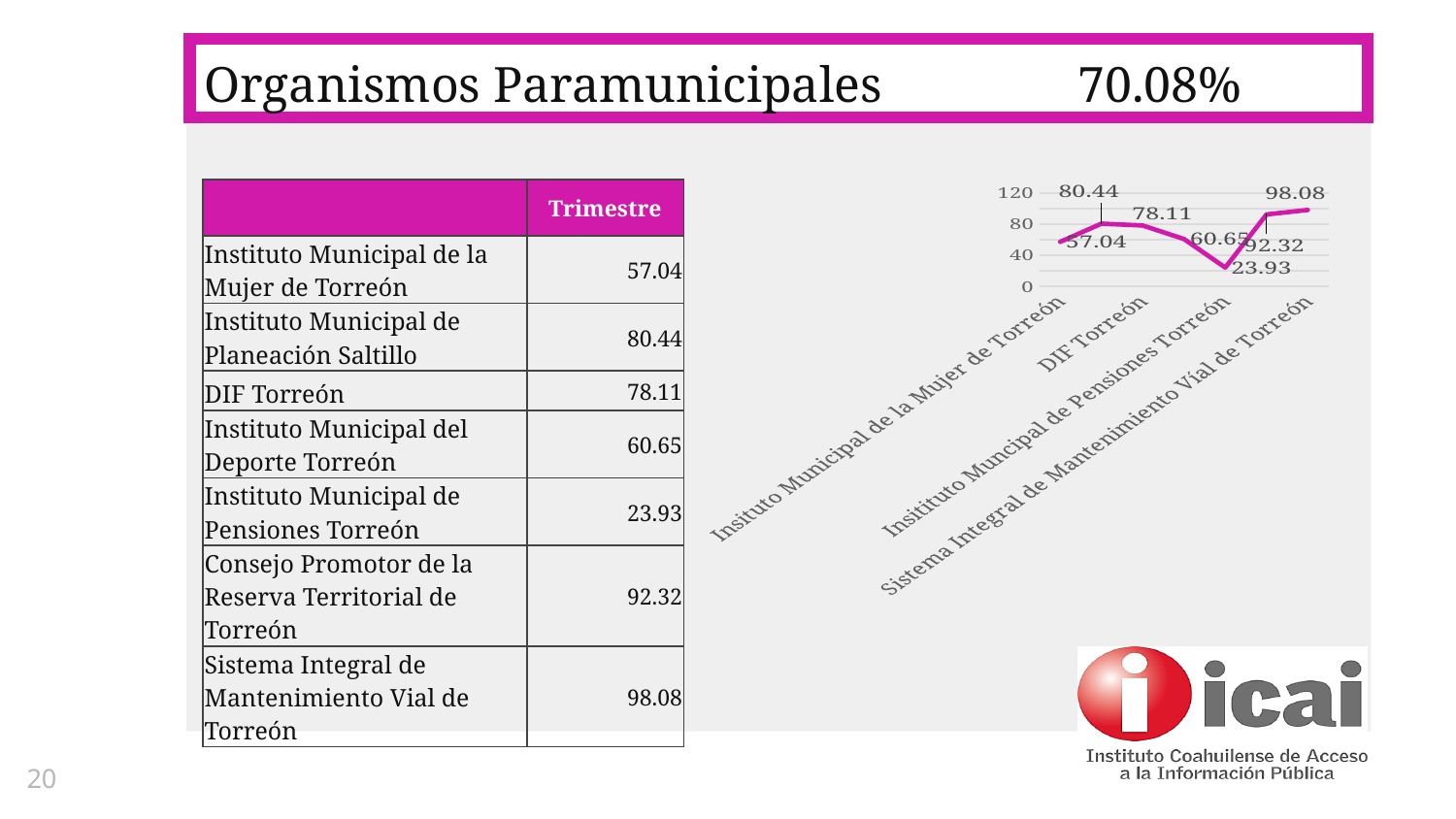
Is the value for Instituto Municipal de Pensiones Torreón on the line chart greater or less than 40? less What is the value plotted for DIF Torreón on the line chart? 78.11 What percentage is shown in the slide title next to "Organismos Paramunicipales"? 70.08% What is the difference between the values for Sistema Integral de Mantenimiento Vial de Torreón (98.08) and Instituto Municipal de Pensiones Torreón (23.93) on the line chart? 74.15 How many data points are plotted on the line chart? 7 Which is larger on the line chart: the value for DIF Torreón or the value for Instituto Municipal de la Mujer de Torreón? DIF Torreón What is the value plotted for Instituto Municipal de Pensiones Torreón on the line chart? 23.93 What type of chart is shown on the slide? line chart Which category has the lowest value on the line chart? Instituto Municipal de Pensiones Torreón Which category has the highest value on the line chart? Sistema Integral de Mantenimiento Vial de Torreón What is the value plotted for Sistema Integral de Mantenimiento Vial de Torreón on the line chart? 98.08 What is the highest tick value shown on the vertical axis of the line chart? 120